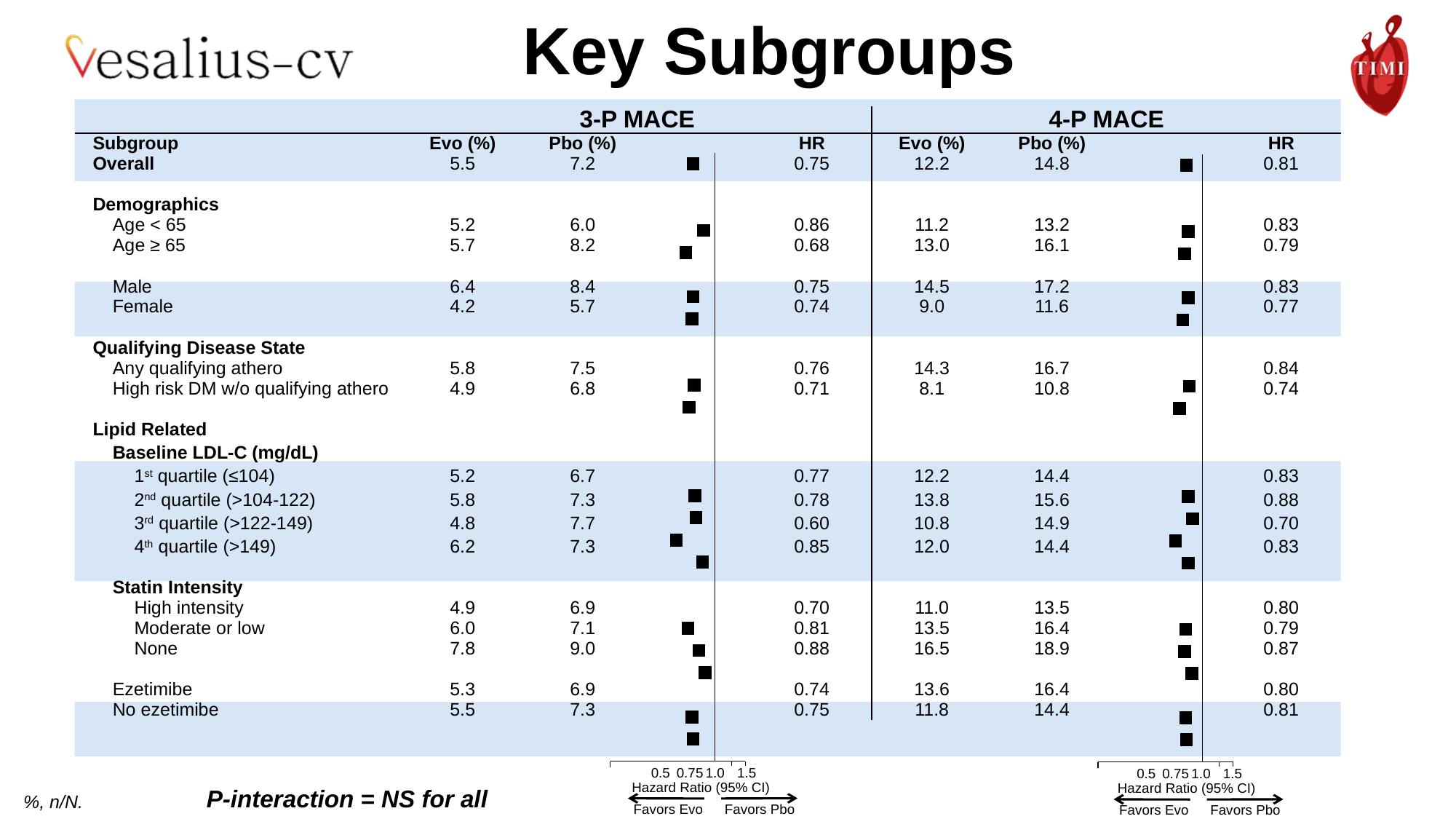
In the 4-P MACE forest plot, what is the hazard ratio for the Overall group? 0.81 In the 4-P MACE forest plot, which subgroup has the highest hazard ratio? 2nd quartile (>104-122) In the 4-P MACE forest plot, which subgroup has the lowest hazard ratio? 3rd quartile (>122-149) In the 3-P MACE forest plot, which has the larger hazard ratio: Age < 65 or Age ≥ 65? Age < 65 In the 3-P MACE forest plot, what is the hazard ratio for the 3rd quartile (>122-149) of baseline LDL-C? 0.60 What tick values are shown on the Hazard Ratio axis of the 3-P MACE forest plot? 0.5, 0.75, 1.0, 1.5 In the 3-P MACE forest plot, which subgroup has the highest hazard ratio? None (statin intensity) In the 3-P MACE forest plot, what is the hazard ratio for the Overall group? 0.75 What kind of chart is used to display the hazard ratios on this slide? Forest plot In the 3-P MACE forest plot, which subgroup has the lowest hazard ratio? 3rd quartile (>122-149) In the 3-P MACE forest plot, is the hazard ratio for Female greater or less than 1.0? less What is the difference between the Overall hazard ratio in the 4-P MACE plot and the Overall hazard ratio in the 3-P MACE plot? 0.06